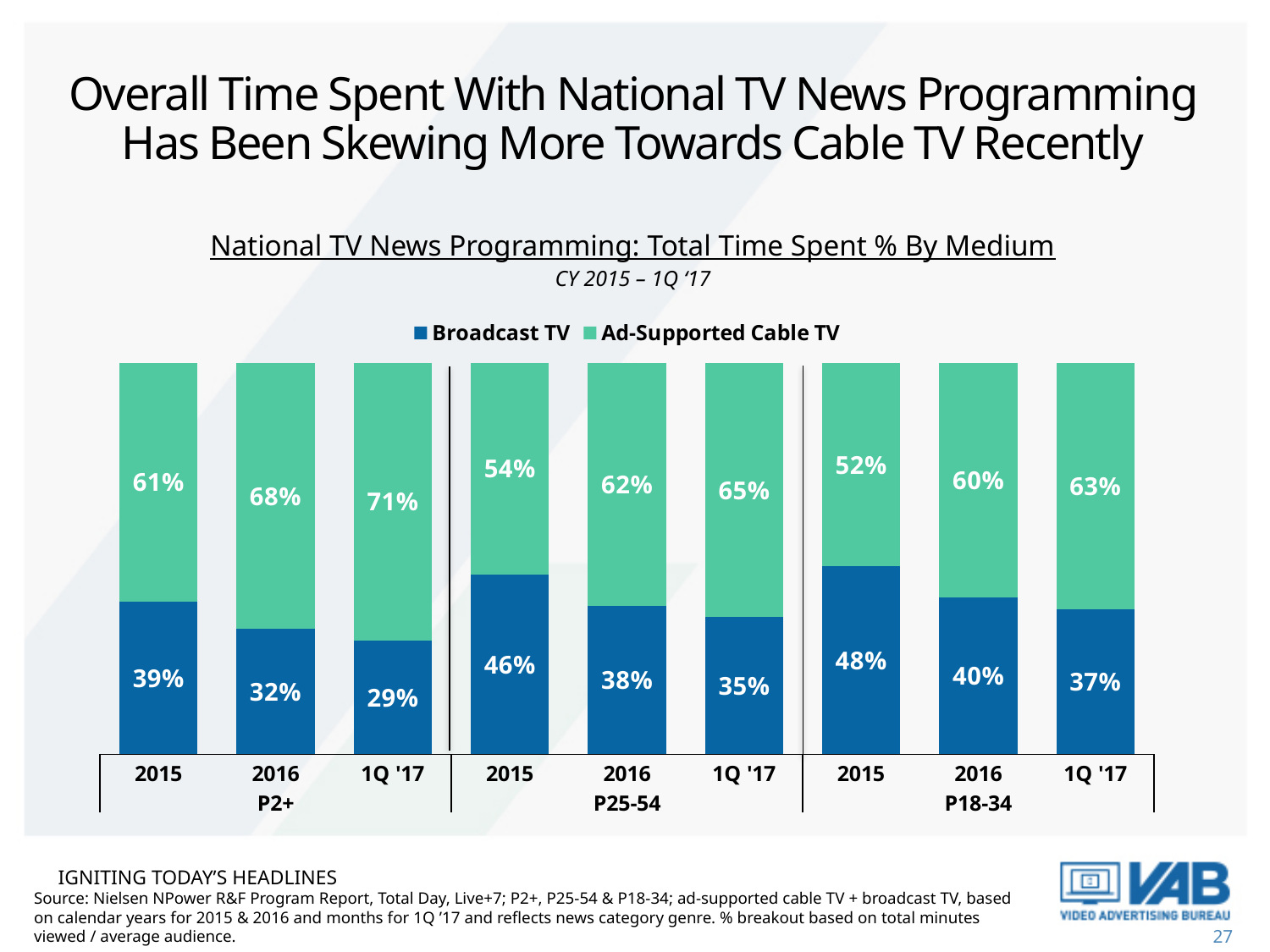
How does the Broadcast TV share for P25-54 change from 2015 to 1Q '17? It falls What is the Ad-Supported Cable TV share for P18-34 in 1Q '17? 63% Which group and period has the highest Broadcast TV share? P18-34, 2015 (48%) How many bars are plotted in the chart? 9 By how many percentage points did the Ad-Supported Cable TV share for P2+ change from 2015 to 1Q '17? 10 percentage points Which is larger: the Broadcast TV share for P25-54 in 2015 or for P18-34 in 2015? P18-34 in 2015 (48%) How many series does the legend list? 2 Which group and period has the lowest Broadcast TV share? P2+, 1Q '17 (29%) What is the Broadcast TV share for P2+ in 2015? 39% What is the total of the stacked bar for P18-34 in 2016? 100% What is the Ad-Supported Cable TV share for P25-54 in 2016? 62% What kind of chart is shown on the slide? Stacked bar chart